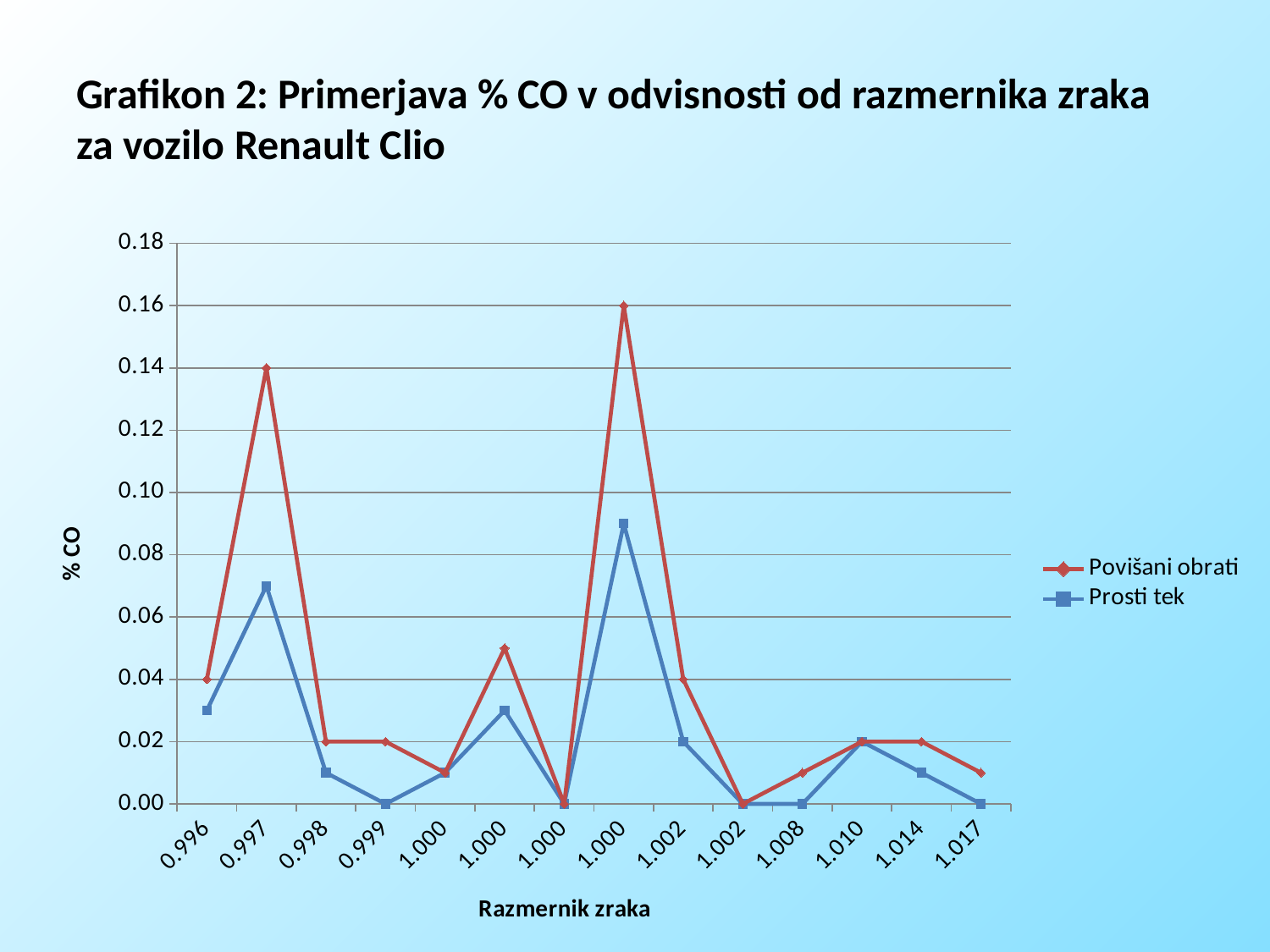
Is the highest value of the Prosti tek series greater or less than 0.08? greater What is the title of the vertical axis? % CO What is the value of Povišani obrati at razmernik zraka 0.996? 0.04 How many data points are plotted along the x axis for each series? 14 What is the highest value reached by the Povišani obrati series? 0.16 What kind of chart is shown on the slide? line chart At razmernik zraka 0.997, which series has the higher % CO value? Povišani obrati Does the Prosti tek series rise or fall from 1.010 to 1.017? fall How many series does the legend list? 2 What is the difference between the Povišani obrati values at 0.997 and 0.996? 0.10 What is the value of Prosti tek at razmernik zraka 0.999? 0.00 What is the value of Povišani obrati at razmernik zraka 0.997? 0.14